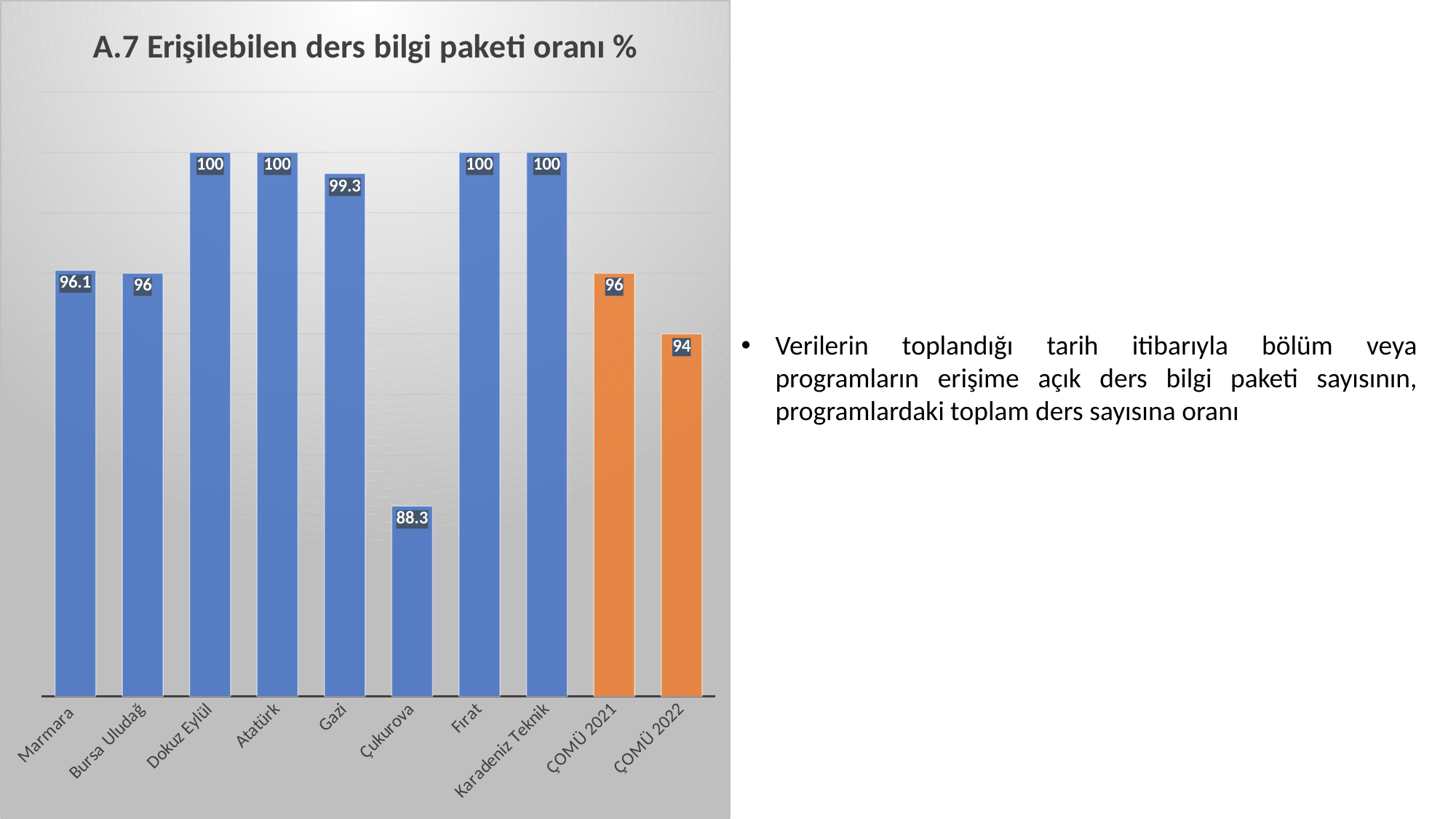
How many categories are shown on the x axis? 10 Which categories are shown with orange bars? ÇOMÜ 2021 and ÇOMÜ 2022 What is the difference between the values for Dokuz Eylül and Çukurova? 11.7 What kind of chart is this? bar chart Which category has the lowest value? Çukurova Which is larger, the value for Marmara or the value for ÇOMÜ 2022? Marmara What is the title of the chart? A.7 Erişilebilen ders bilgi paketi oranı % What is the value for ÇOMÜ 2022? 94 What is the value for Gazi? 99.3 What is the value for Çukurova? 88.3 What is the difference between the values for ÇOMÜ 2021 and ÇOMÜ 2022? 2 What is the value for Marmara? 96.1